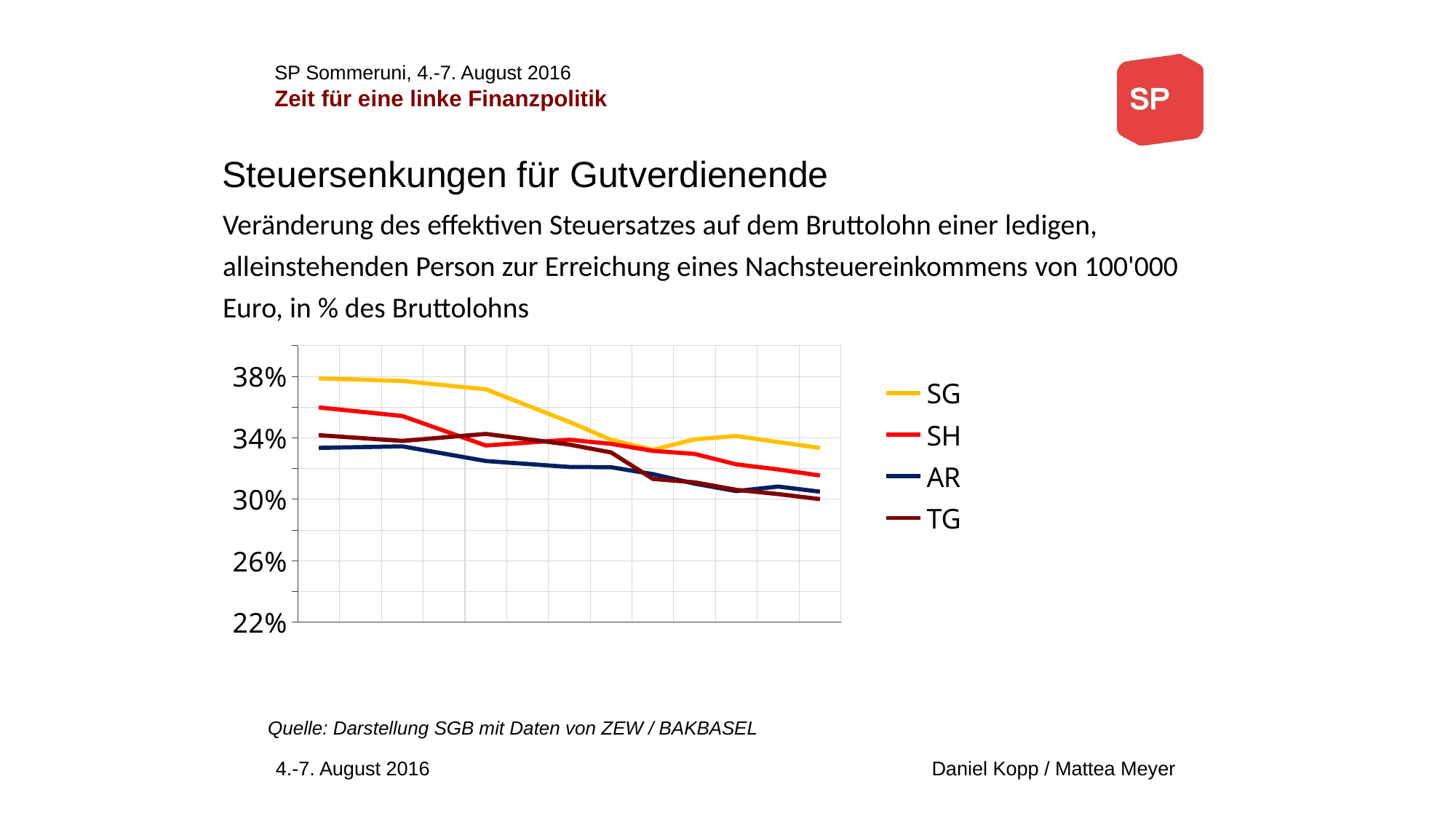
Which series has the lowest value at the left end of the chart? AR Is the value for SG at the left end of the chart greater or less than 34%? greater At the right end of the chart, which is larger, the value for SG or the value for SH? SG Is the value for AR at the left end of the chart greater or less than 34%? less Which series has the highest value at the left end of the chart? SG Does the SH line rise or fall overall from left to right? fall What kind of chart is shown on the slide? line chart Is the value for SH at the right end of the chart greater or less than 30%? greater Does the SG line rise or fall overall from left to right? fall How many series does the legend list? 4 Which series is shown in dark blue in the legend? AR Which series is shown in yellow in the legend? SG